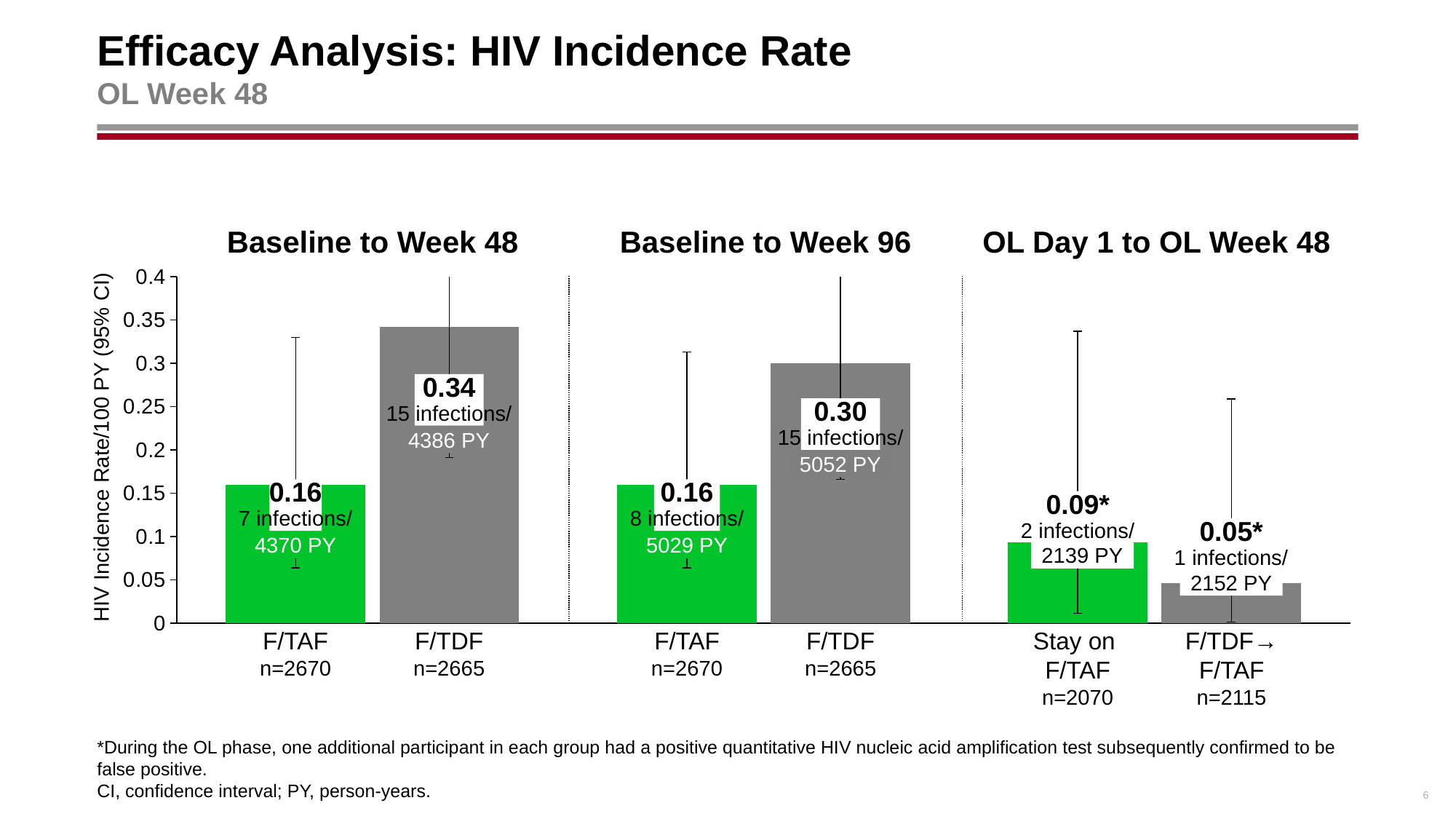
In the Baseline to Week 96 panel, what is the HIV incidence rate for F/TAF? 0.16 In the Baseline to Week 48 panel, what is the HIV incidence rate for F/TDF? 0.34 What type of chart is shown on the slide? Bar chart In the OL Day 1 to OL Week 48 panel, what is the HIV incidence rate for the F/TDF→F/TAF group? 0.05* How many bars are plotted in total across the three panels? 6 How many infections are reported for F/TDF in the Baseline to Week 96 panel? 15 infections In the Baseline to Week 96 panel, which group has the higher HIV incidence rate, F/TAF or F/TDF? F/TDF Across all panels, which bar has the highest HIV incidence rate? F/TDF (Baseline to Week 48) Across all panels, which bar has the lowest HIV incidence rate? F/TDF→F/TAF (OL Day 1 to OL Week 48) How many person-years are reported for the Stay on F/TAF group in the OL Day 1 to OL Week 48 panel? 2139 PY In the Baseline to Week 48 panel, what is the difference in HIV incidence rate between F/TDF and F/TAF? 0.18 What is the label of the y-axis? HIV Incidence Rate/100 PY (95% CI)